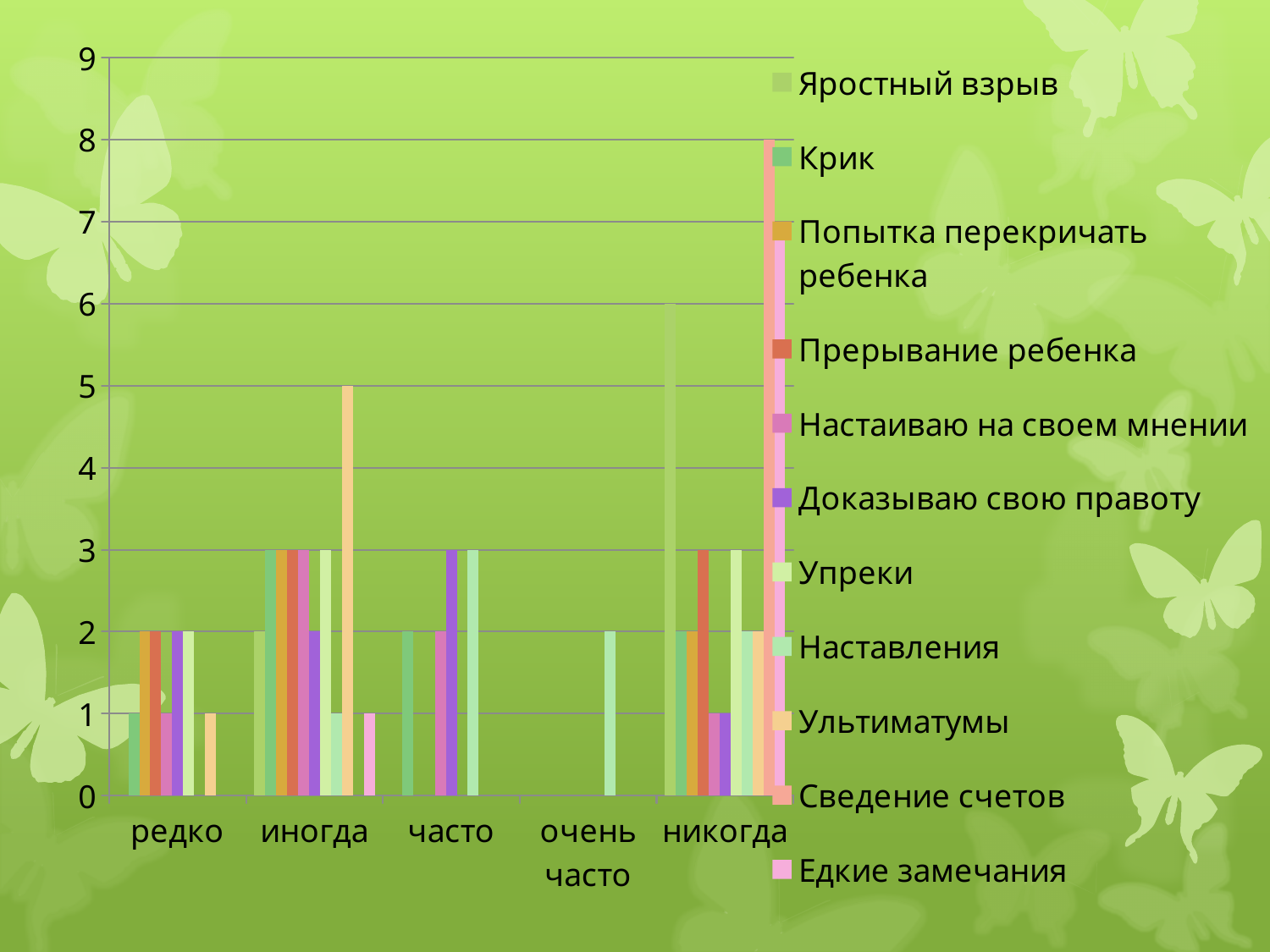
What is the value for Сведение счетов in the никогда category? 8 What is the value for Наставления in the очень часто category? 2 Is the value for Ультиматумы in the иногда category greater or less than 4? greater How many series does the legend list? 11 How many categories are shown along the x axis? 5 Which is larger: Ультиматумы in иногда or Яростный взрыв in никогда? Яростный взрыв in никогда Which category contains the tallest bar in the chart? никогда What kind of chart is shown on the slide? bar chart What is the value for Яростный взрыв in the никогда category? 6 What is the value for Ультиматумы in the иногда category? 5 What is the first entry listed in the legend? Яростный взрыв What is the difference between Сведение счетов in никогда and Ультиматумы in иногда? 3